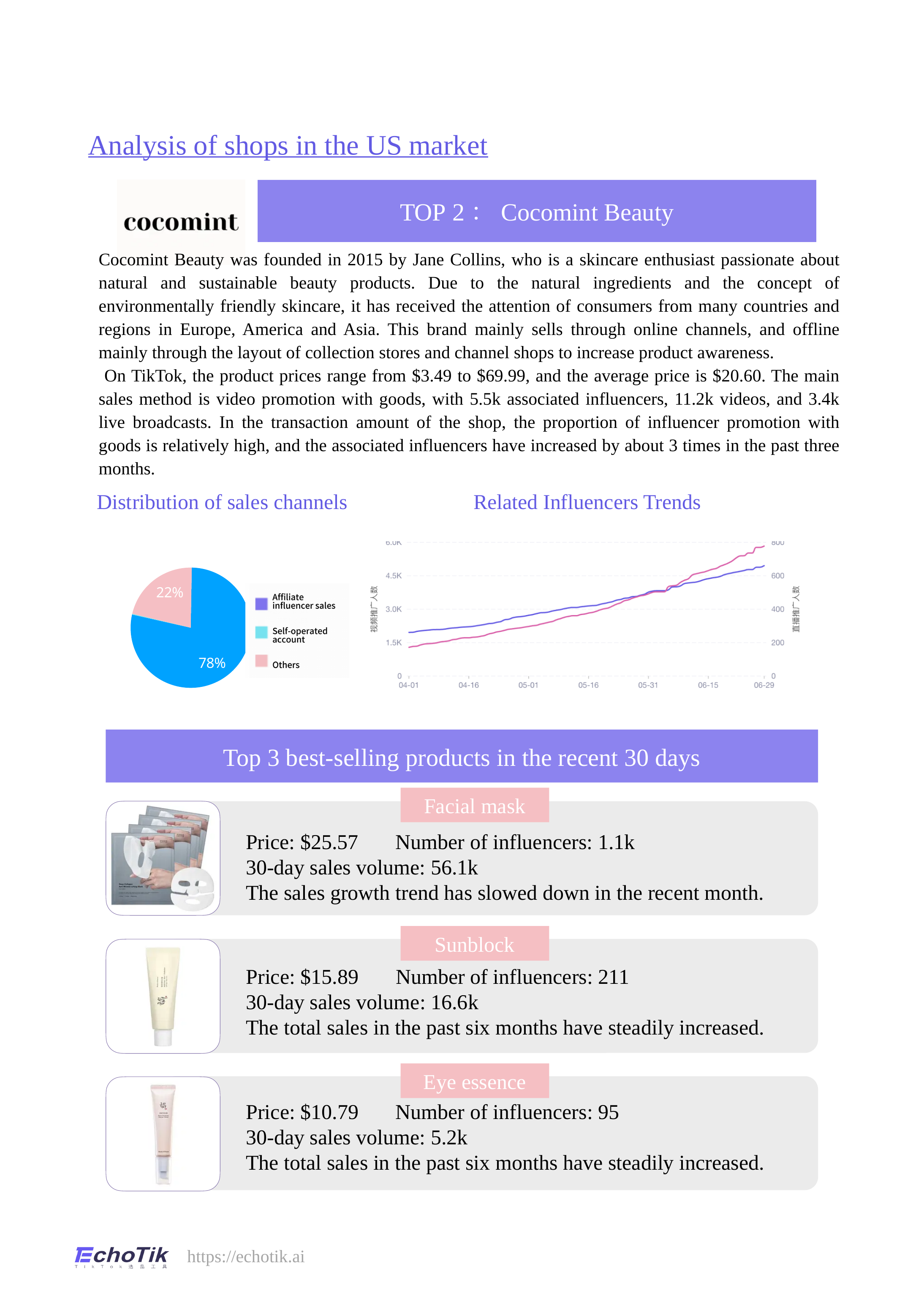
In the 'Distribution of sales channels' pie chart, what is the difference between the two labelled slices? 56% In the 'Distribution of sales channels' pie chart, which labelled slice is larger, the 78% slice or the 22% slice? the 78% slice In the 'Distribution of sales channels' pie chart, what share does the pink 'Others' slice have? 22% What kind of chart is the 'Distribution of sales channels' chart? pie chart In the 'Distribution of sales channels' pie chart, which legend entry is shown in pink? Others How many entries does the legend of the 'Distribution of sales channels' pie chart list? 3 What kind of chart is the 'Related Influencers Trends' chart? line chart In the 'Related Influencers Trends' chart, what is the highest tick value on the right-hand axis? 800 In the 'Distribution of sales channels' pie chart, what share does the largest slice have? 78% How many lines are plotted in the 'Related Influencers Trends' chart? 2 In the 'Related Influencers Trends' chart, what is the first date shown on the x axis? 04-01 In the 'Related Influencers Trends' chart, do the lines rise or fall from 04-01 to 06-29? rise